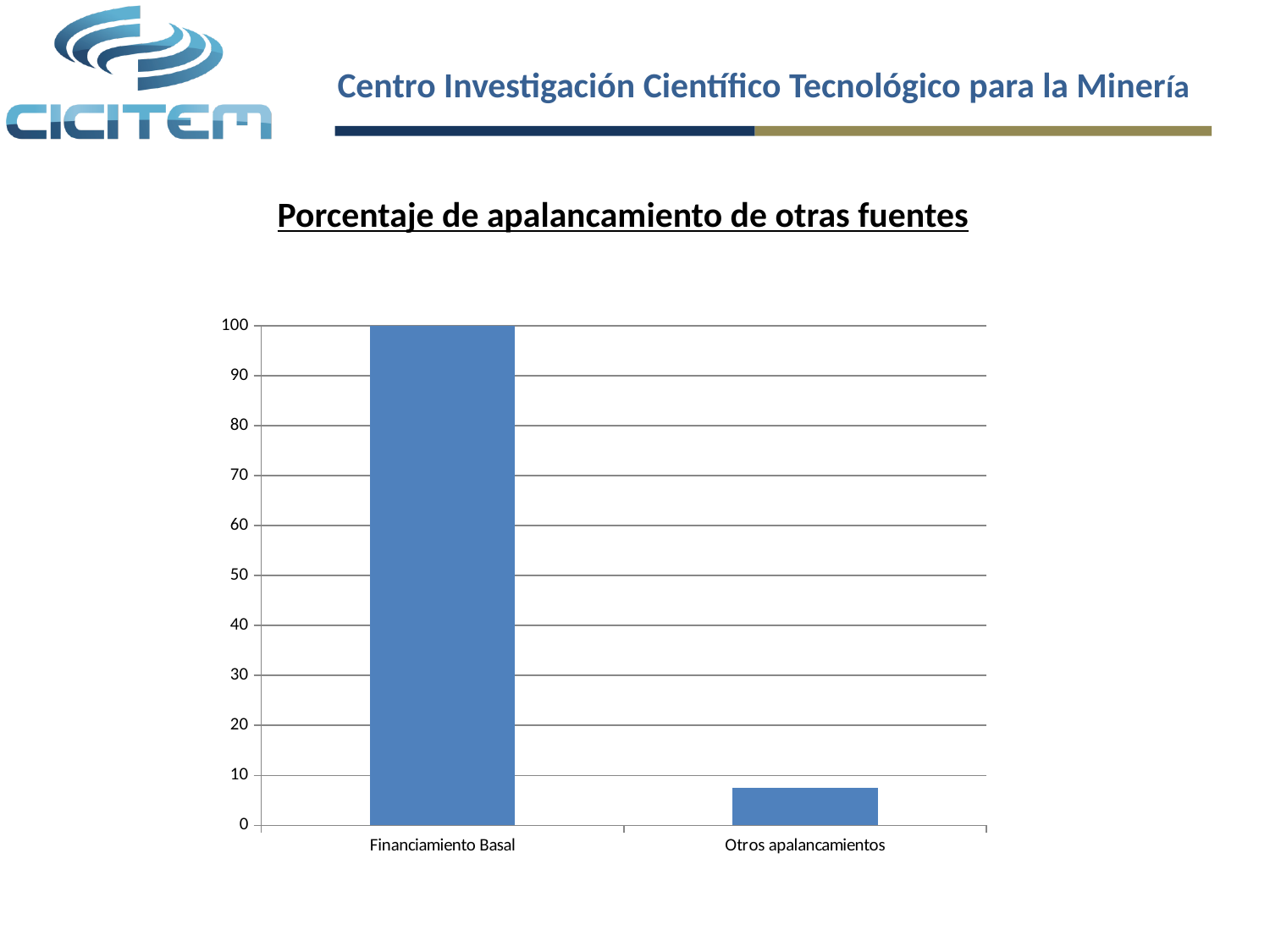
What is the highest value shown on the y axis? 100 What is the value for Financiamiento Basal? 100 Which category has the highest value? Financiamiento Basal How many categories are plotted on the x axis? 2 Is the value for Otros apalancamientos greater or less than 10? less Do the values rise or fall from left to right along the x axis? fall What kind of chart is shown on the slide? bar chart Is the value for Financiamiento Basal greater or less than 50? greater What is the title of the chart? Porcentaje de apalancamiento de otras fuentes Which category has the lowest value? Otros apalancamientos Which is larger, the value for Financiamiento Basal or the value for Otros apalancamientos? Financiamiento Basal